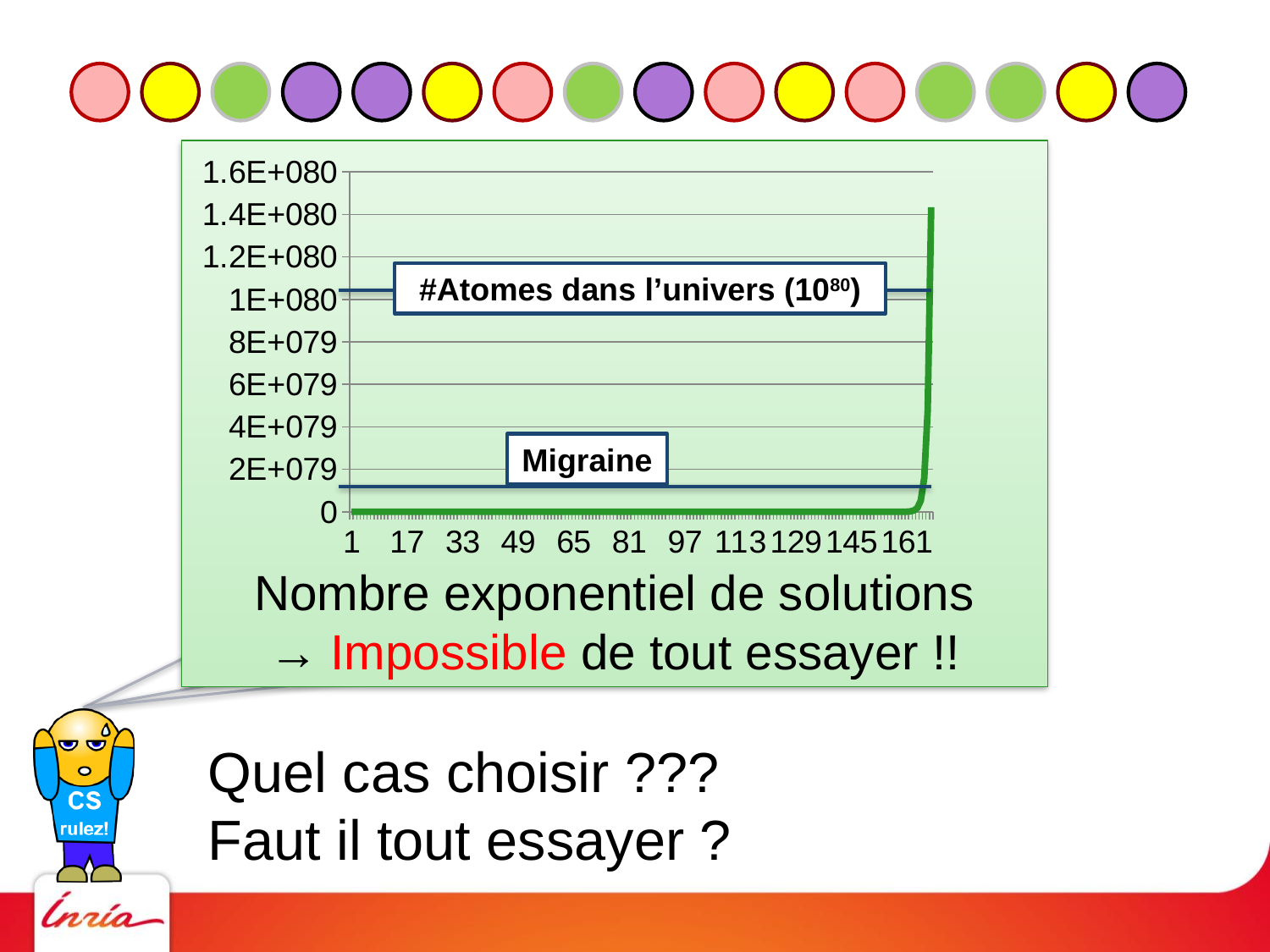
Is the horizontal line labelled '#Atomes dans l'univers' greater or less than 8E+079? greater What kind of chart is shown on the slide? line chart How many tick labels are shown on the x axis of the chart? 11 Is the horizontal line labelled 'Migraine' greater or less than 2E+079? less Is the value of the green curve at x = 81 greater or less than 2E+079? less Which horizontal line is higher on the chart, '#Atomes dans l'univers' or 'Migraine'? #Atomes dans l'univers Does the green curve rise or fall as it moves along the x axis toward 161? rise At what y-axis value does the horizontal line labelled '#Atomes dans l'univers' sit? 1E+080 What is the last tick label on the x axis of the chart? 161 What is the highest value labelled on the y axis of the chart? 1.6E+080